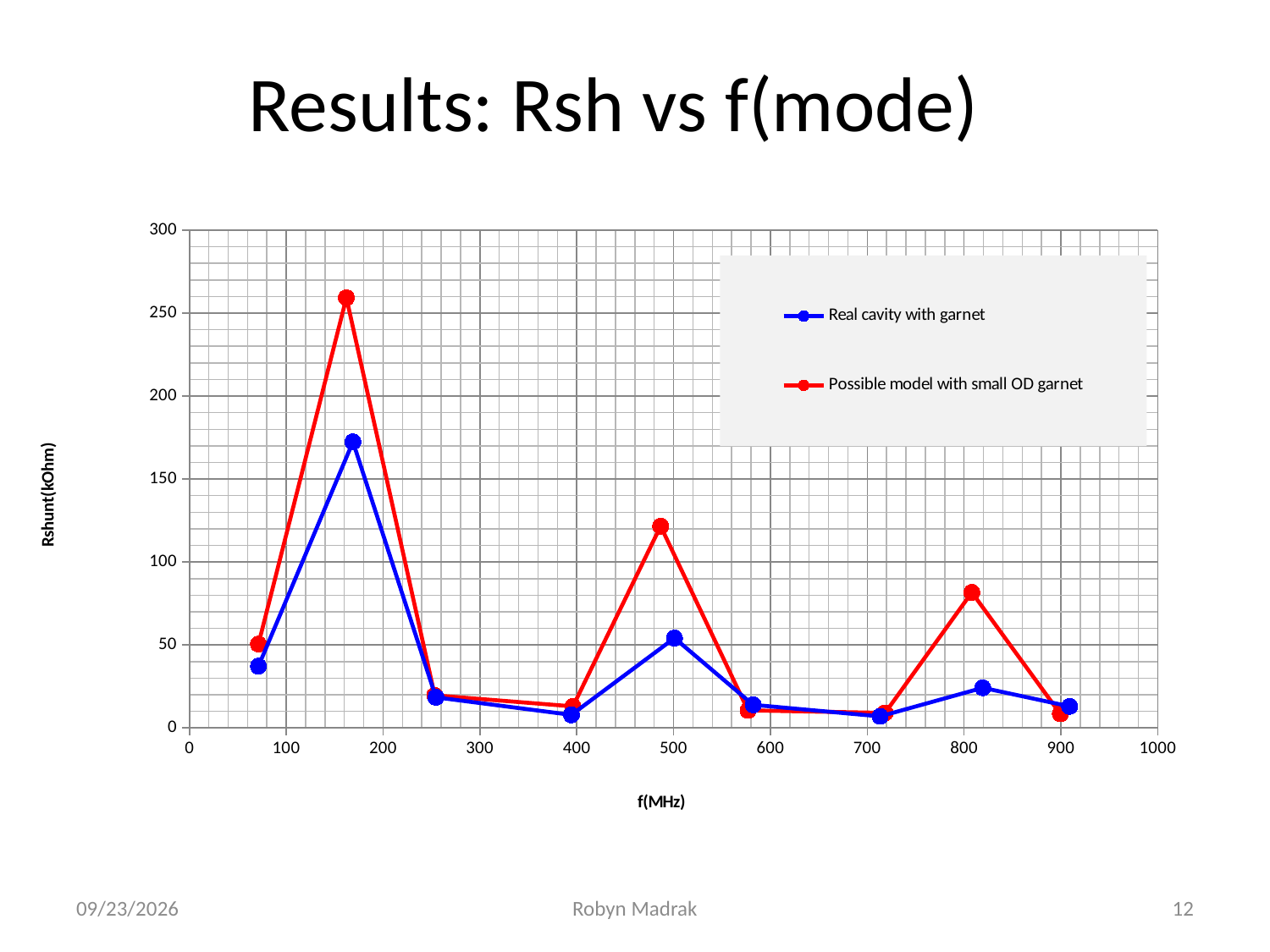
Is the value of the 'Possible model with small OD garnet' series near 810 MHz greater or less than 50? greater How many data points are plotted for the 'Real cavity with garnet' series? 9 At roughly 165 MHz, which series has the higher Rshunt value? Possible model with small OD garnet Is the value of the 'Possible model with small OD garnet' series near 490 MHz greater or less than 100? greater Is the peak value of the 'Possible model with small OD garnet' series near 165 MHz greater or less than 250? greater How many series does the legend list? 2 What kind of chart is shown on the slide? line chart What is the label of the vertical axis? Rshunt(kOhm) What are the two series named in the legend? Real cavity with garnet; Possible model with small OD garnet